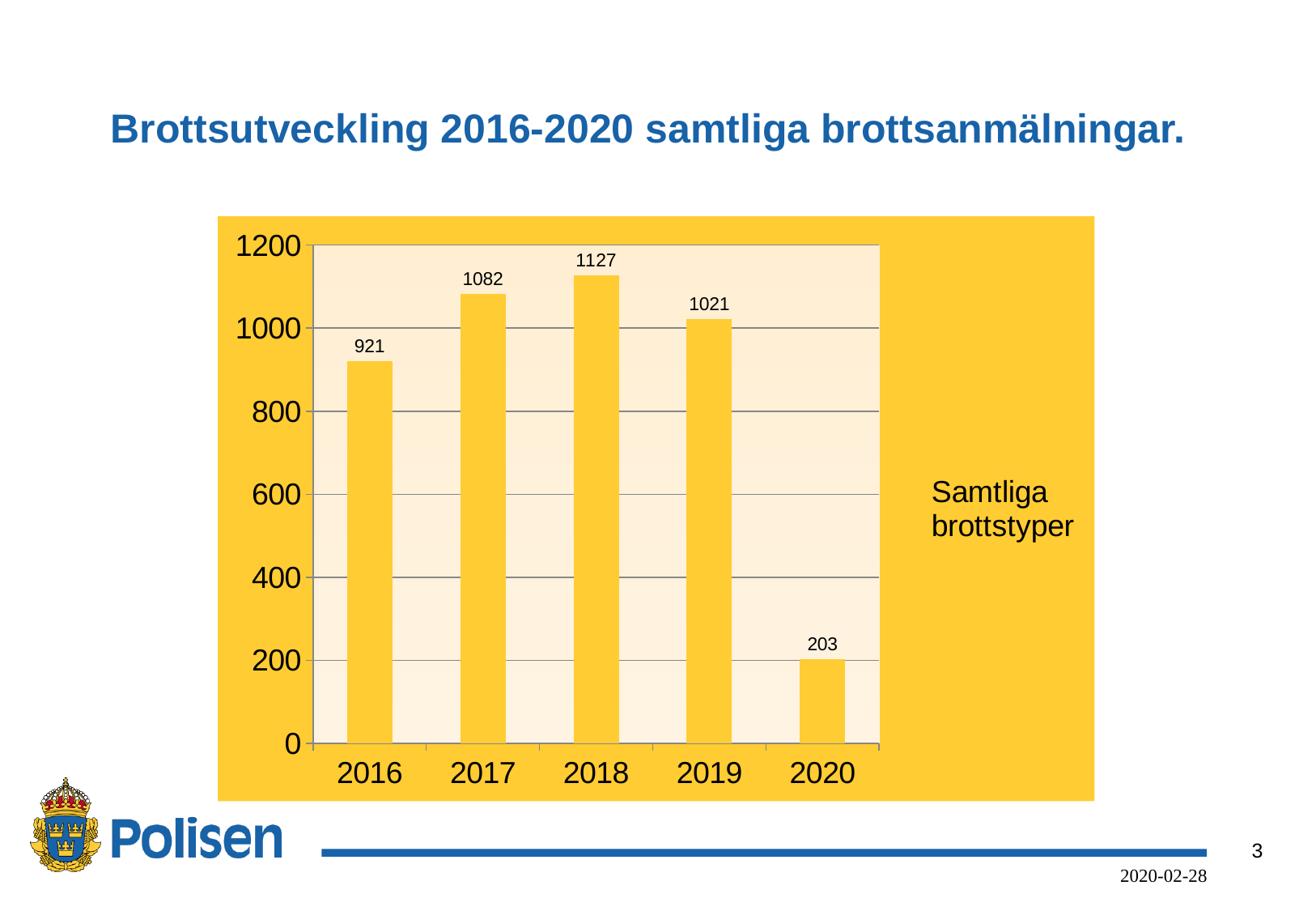
What is the difference between the values for 2018 and 2017? 45 What is the value for 2018? 1127 Which year has the highest value? 2018 Is the value for 2016 greater or less than 1000? less What is the difference between the values for 2019 and 2020? 818 Which is larger, the value for 2017 or the value for 2019? 2017 What is the value for 2020? 203 What is the legend entry shown to the right of the chart? Samtliga brottstyper How many years are shown on the x axis? 5 Which year has the lowest value? 2020 What kind of chart is shown on the slide? bar chart What is the value for 2016? 921